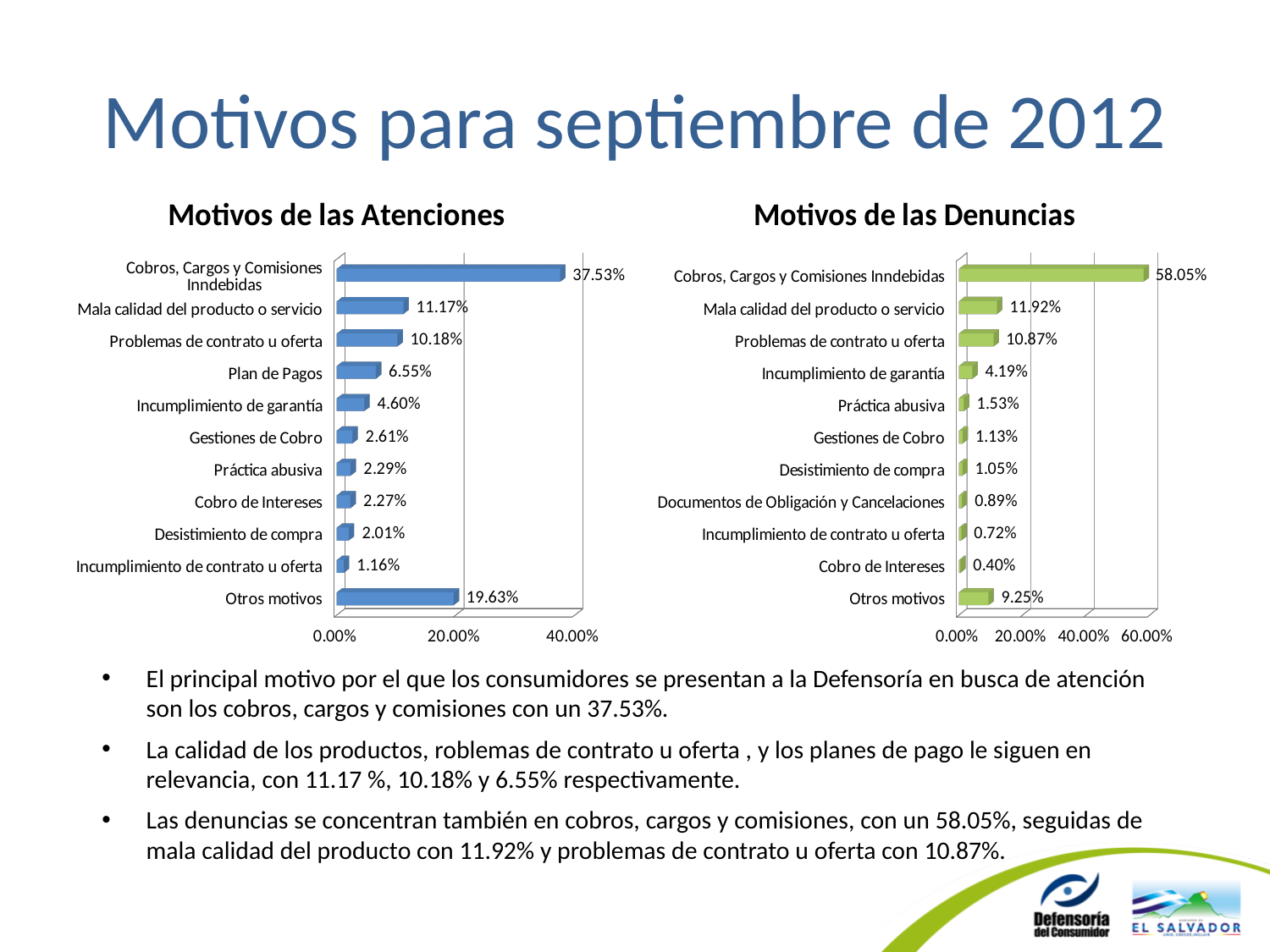
In the 'Motivos de las Atenciones' chart, which category has the lowest value? Incumplimiento de contrato u oferta In the 'Motivos de las Atenciones' chart, what is the difference between Cobros, Cargos y Comisiones Inndebidas and Otros motivos? 17.90% In the 'Motivos de las Denuncias' chart, which category has the lowest value? Cobro de Intereses In the 'Motivos de las Denuncias' chart, what is the value for Otros motivos? 9.25% In the 'Motivos de las Atenciones' chart, what is the value for Plan de Pagos? 6.55% What colour are the bars in the 'Motivos de las Denuncias' chart? Green How many categories are shown in the 'Motivos de las Atenciones' chart? 11 In the 'Motivos de las Atenciones' chart, which category has the highest value? Cobros, Cargos y Comisiones Inndebidas In the 'Motivos de las Denuncias' chart, what is the value for Documentos de Obligación y Cancelaciones? 0.89% What type of chart is 'Motivos de las Denuncias'? Bar chart In the 'Motivos de las Denuncias' chart, which is larger: Incumplimiento de garantía or Práctica abusiva? Incumplimiento de garantía In the 'Motivos de las Denuncias' chart, what is the difference between Cobros, Cargos y Comisiones Inndebidas and Mala calidad del producto o servicio? 46.13%